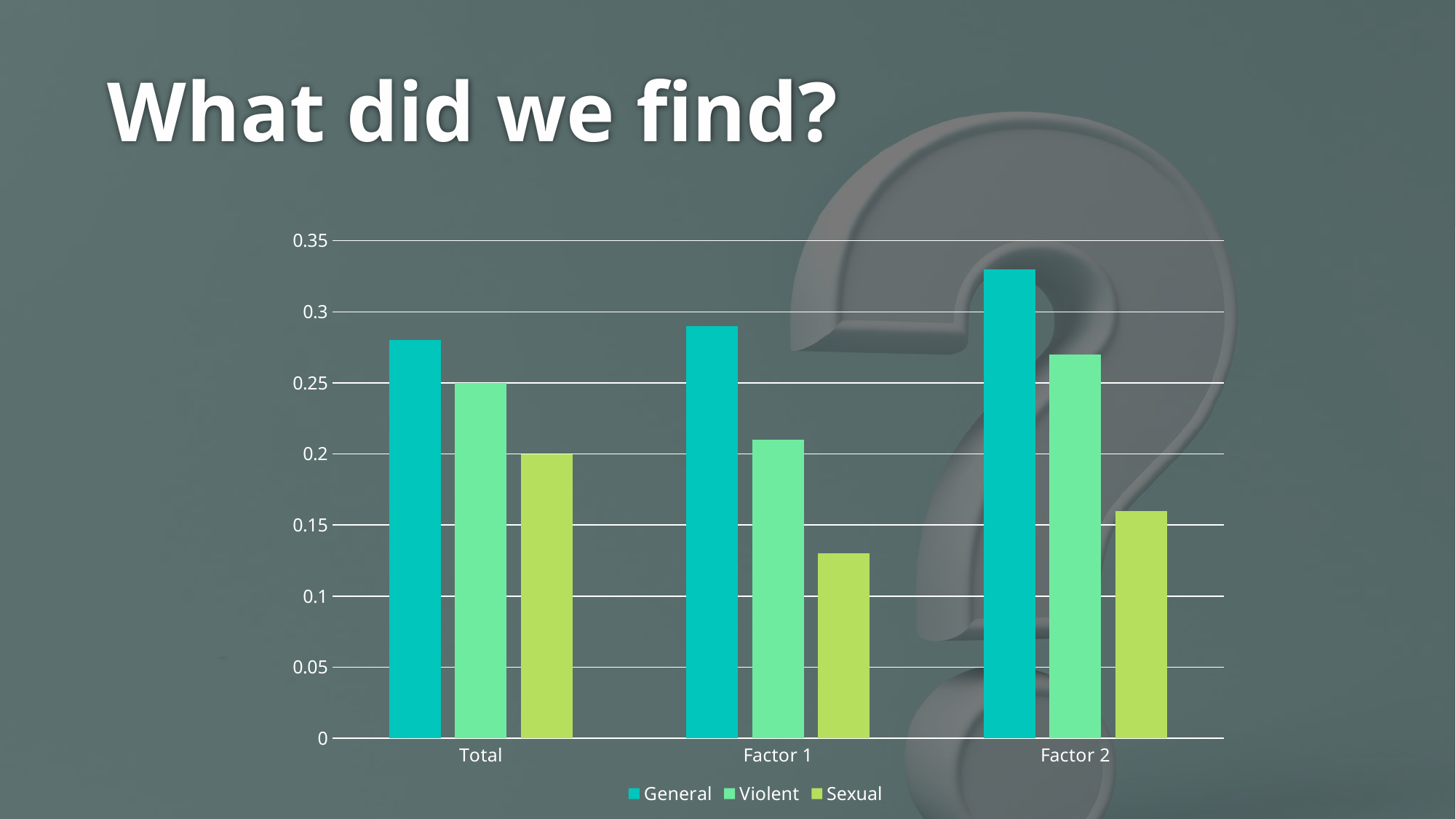
What is the value for Violent in the Total category? 0.25 How many categories are shown on the x axis? 3 Which is larger in Factor 1: the General value or the Violent value? General In which category is the Sexual series lowest? Factor 1 Which series is shown in the darkest teal colour in the legend? General In which category is the General series highest? Factor 2 How many series does the legend list? 3 Is the value for Sexual in Factor 1 greater or less than 0.15? less What type of chart is shown on the slide? bar chart Is the value for Violent in Factor 2 greater or less than 0.25? greater What is the value for Sexual in the Total category? 0.2 Is the value for General in Factor 2 greater or less than 0.3? greater